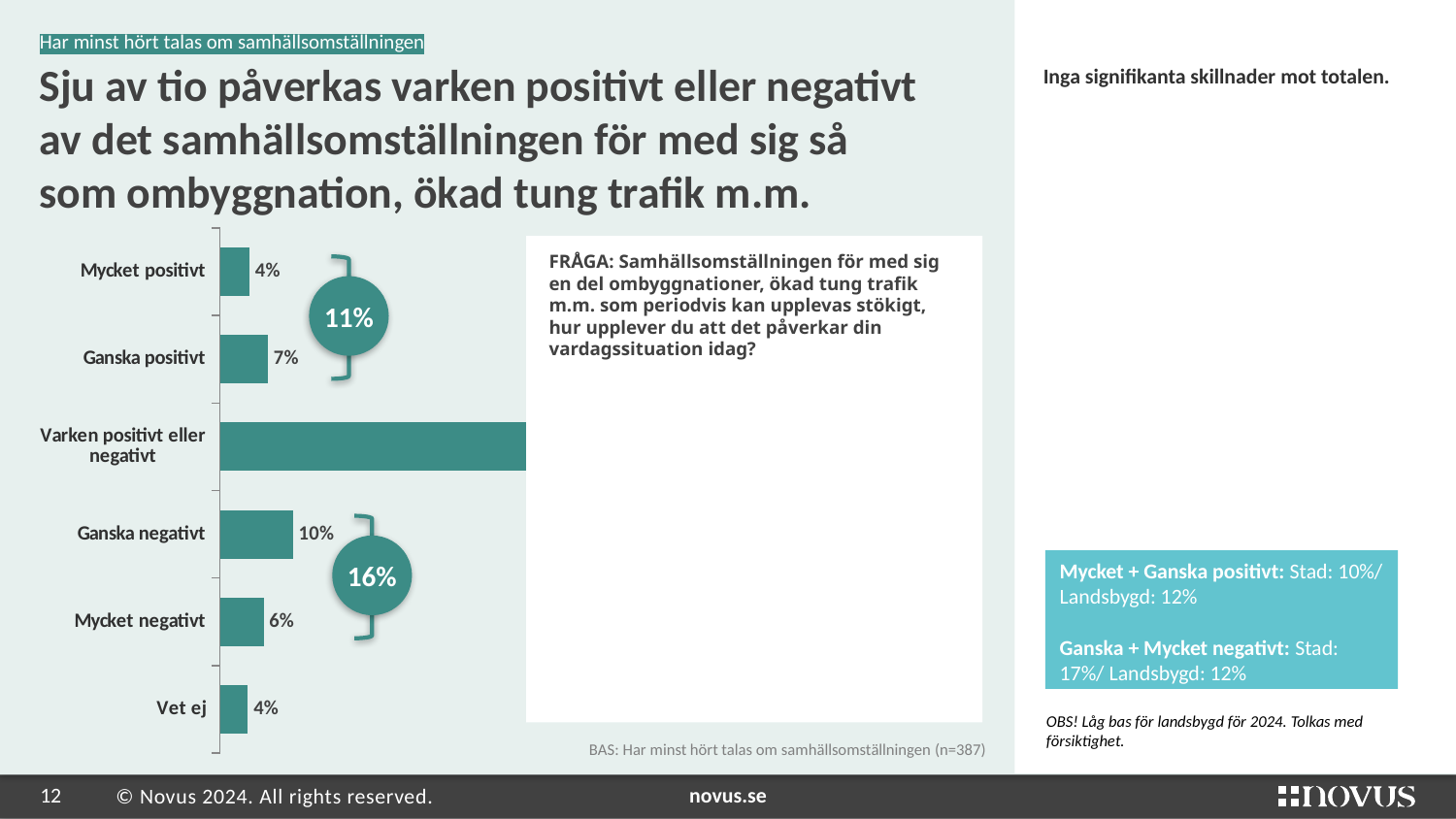
What is the value for Vet ej? 4% Which category has the longest bar? Varken positivt eller negativt What is the value for Mycket positivt? 4% What kind of chart is shown on the slide? Bar chart How many categories are shown in the chart? 6 What is the value for Ganska negativt? 10% What combined value is shown for Ganska negativt and Mycket negativt together? 16% Which is larger, Ganska negativt or Mycket negativt? Ganska negativt What is the difference between Ganska negativt and Ganska positivt? 3% What combined value is shown for Mycket positivt and Ganska positivt together? 11% What is the value for Mycket negativt? 6% What is the value for Ganska positivt? 7%